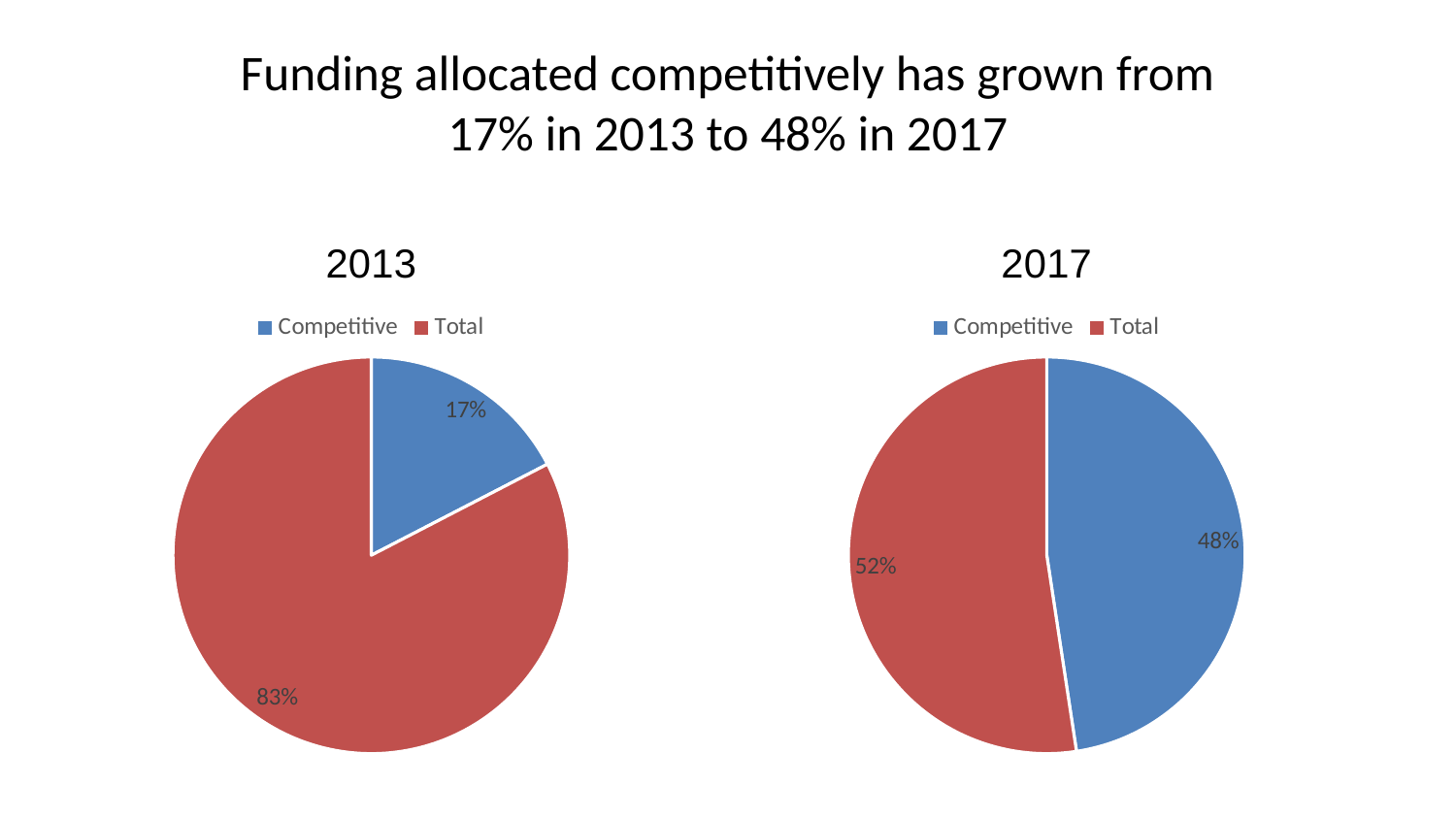
How many slices does the 2017 pie chart have? 2 In the 2017 pie chart, what share is labelled for the Total slice? 52% How many entries does the legend of the 2013 pie chart list? 2 What kind of chart is the 2013 chart? Pie chart In the 2013 pie chart, what share is labelled for the Total slice? 83% In the 2017 pie chart, which slice is the smallest? Competitive Is the Competitive share larger in the 2013 pie chart or the 2017 pie chart? 2017 In the 2013 pie chart, which slice is the largest? Total In the 2017 pie chart, what is the difference in percentage points between the Total slice and the Competitive slice? 4 In the 2013 pie chart, what share is labelled for the Competitive slice? 17% In the 2013 pie chart, what is the difference in percentage points between the Total slice and the Competitive slice? 66 In the 2017 pie chart, what share is labelled for the Competitive slice? 48%